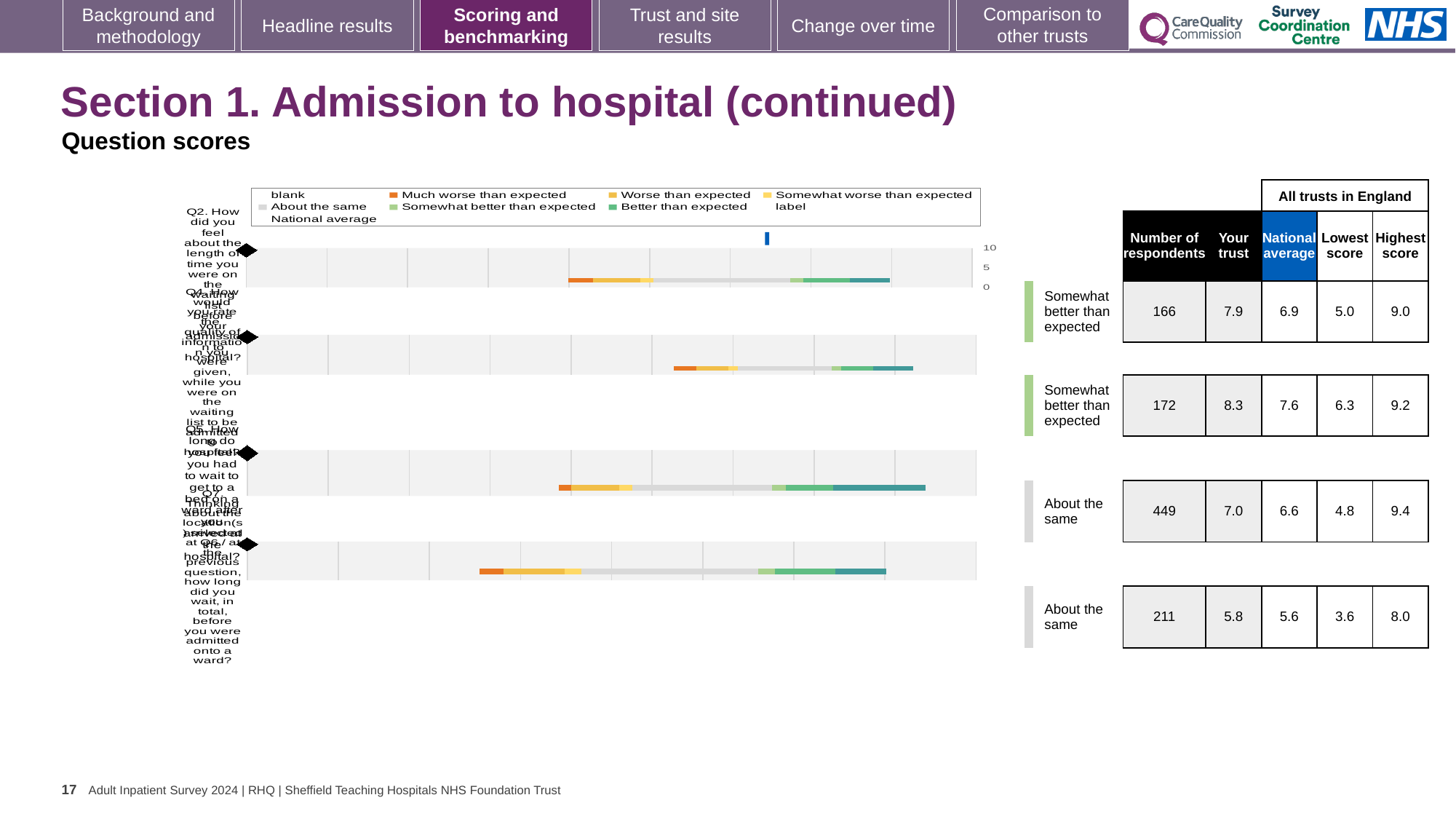
In the table beside the chart, what is the 'Your trust' score in the first row (166 respondents)? 7.9 In the table beside the chart, what is the 'Lowest score' in the fourth row (211 respondents)? 3.6 In the table beside the chart, what is the lowest 'Your trust' score listed? 5.8 In the table beside the chart, which is larger in the first row: the 'Your trust' score or the national average? Your trust What kind of chart is shown on the slide? bar chart What is the maximum value shown on the chart's axis? 10 Which legend entry is shown in dark orange? Much worse than expected How many question bars are plotted in the chart? 4 In the table beside the chart, what is the national average in the first row (166 respondents)? 6.9 In the table beside the chart, what is the highest value in the 'Highest score' column? 9.4 In the table beside the chart, what is the difference between the 'Your trust' score and the national average in the first row? 1.0 In the table beside the chart, which row has the highest number of respondents? the third row (449)